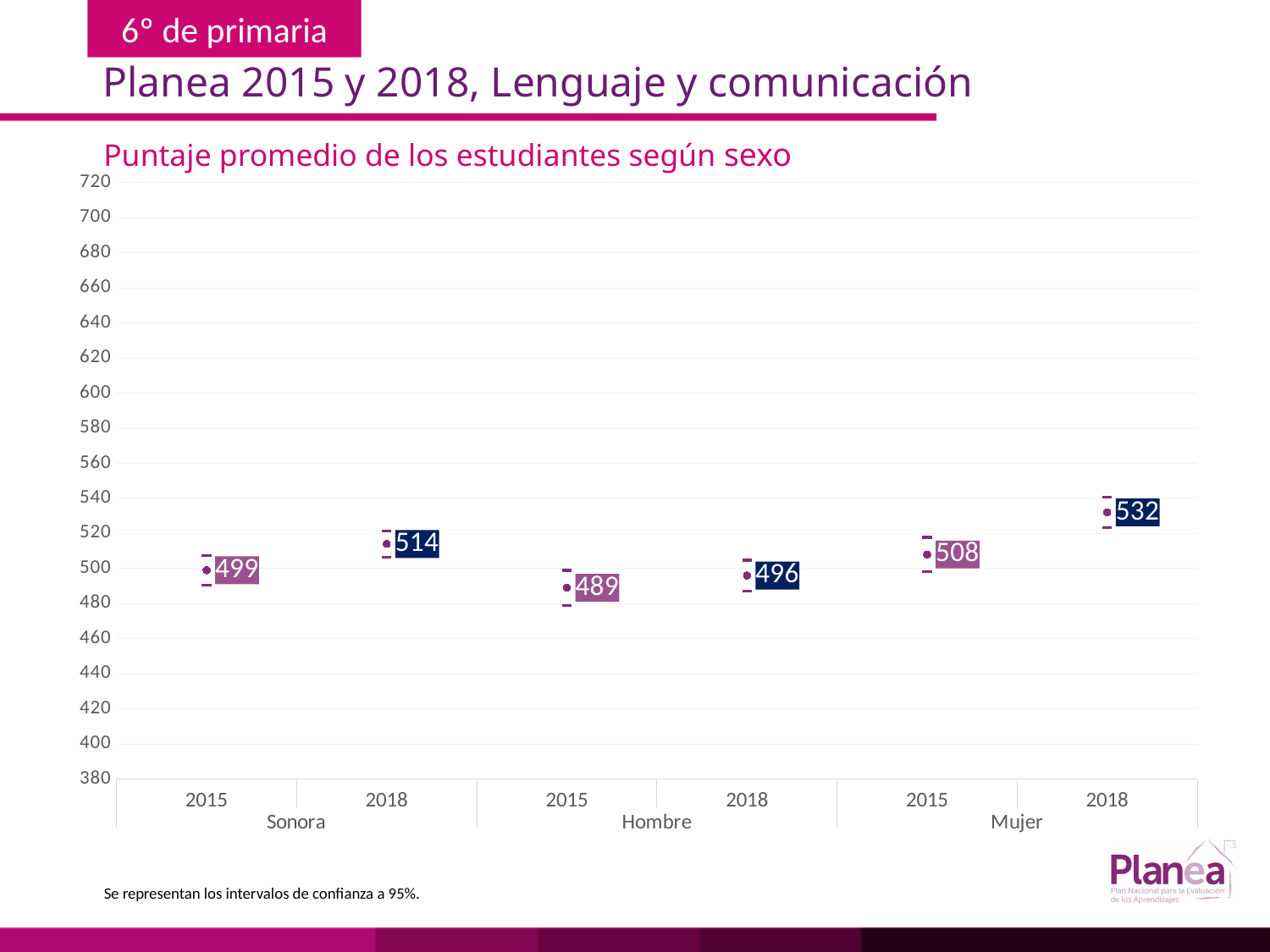
Which group and year has the lowest average score? Hombre 2015 What is the average score for Mujer in 2018? 532 Is the value for Hombre in 2015 greater or less than 500? less What is the title of the chart? Puntaje promedio de los estudiantes según sexo What is the difference between the Mujer score in 2018 and the Mujer score in 2015? 24 What is the average score for Hombre in 2018? 496 How many data points are plotted on the chart? 6 What is the difference between the Sonora score in 2018 and the Sonora score in 2015? 15 Which group and year has the highest average score? Mujer 2018 Which is larger, the Hombre score in 2018 or the Mujer score in 2015? Mujer 2015 What is the average score for Sonora in 2015? 499 Does the score rise or fall from 2015 to 2018 for each group? rise